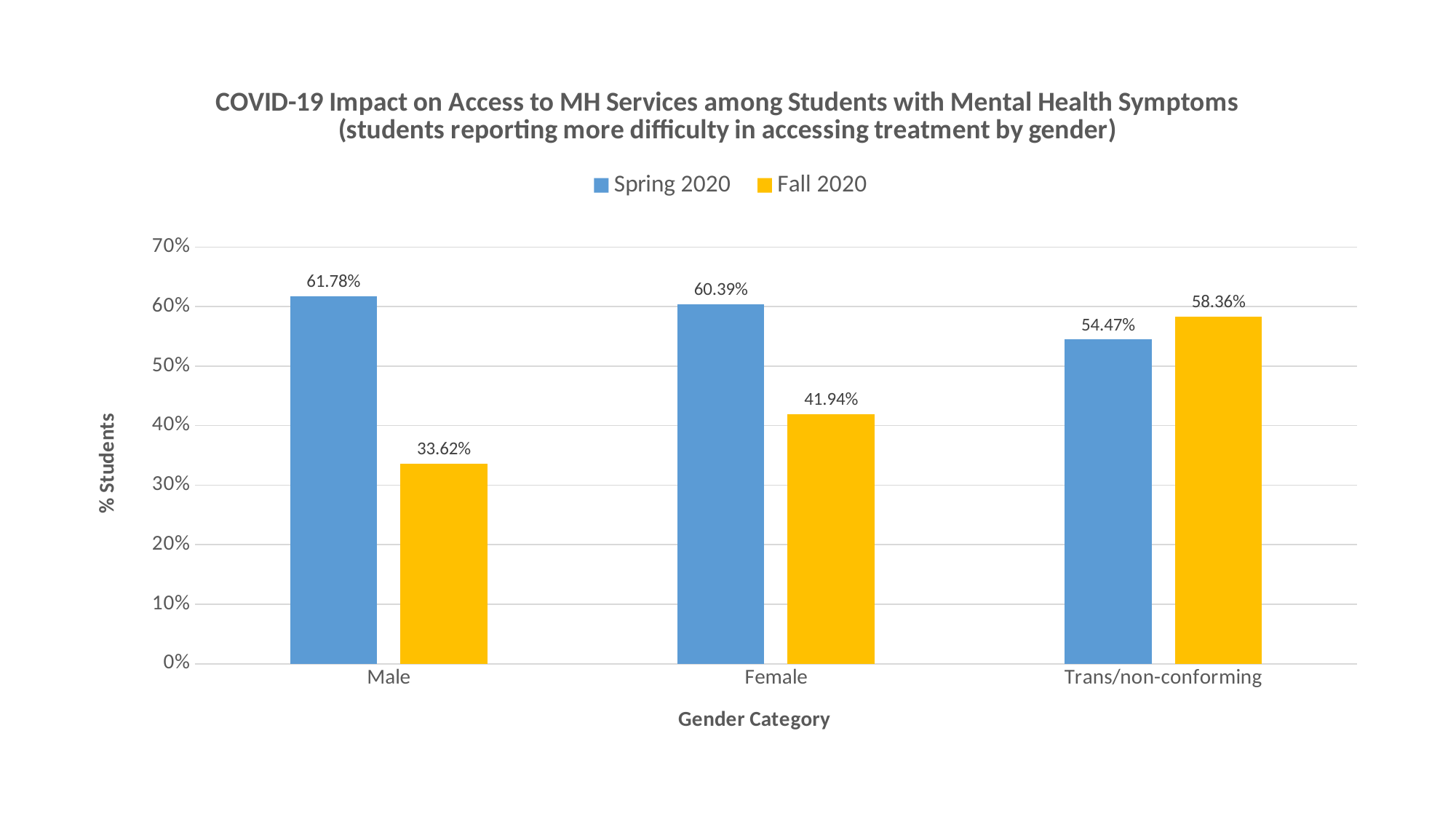
Which gender category has the highest Spring 2020 value? Male What kind of chart is shown on the slide? bar chart What is the difference between the Spring 2020 and Fall 2020 values for Male? 28.16% What is the Spring 2020 value for Male? 61.78% How many series does the legend list? 2 Which gender category has the lowest Fall 2020 value? Male For Trans/non-conforming, which is larger: the Spring 2020 value or the Fall 2020 value? Fall 2020 How many gender categories are shown on the x axis? 3 What is the Fall 2020 value for Trans/non-conforming? 58.36% Is the Fall 2020 value for Female greater or less than 50%? less What is the label of the y axis? % Students What is the Fall 2020 value for Female? 41.94%